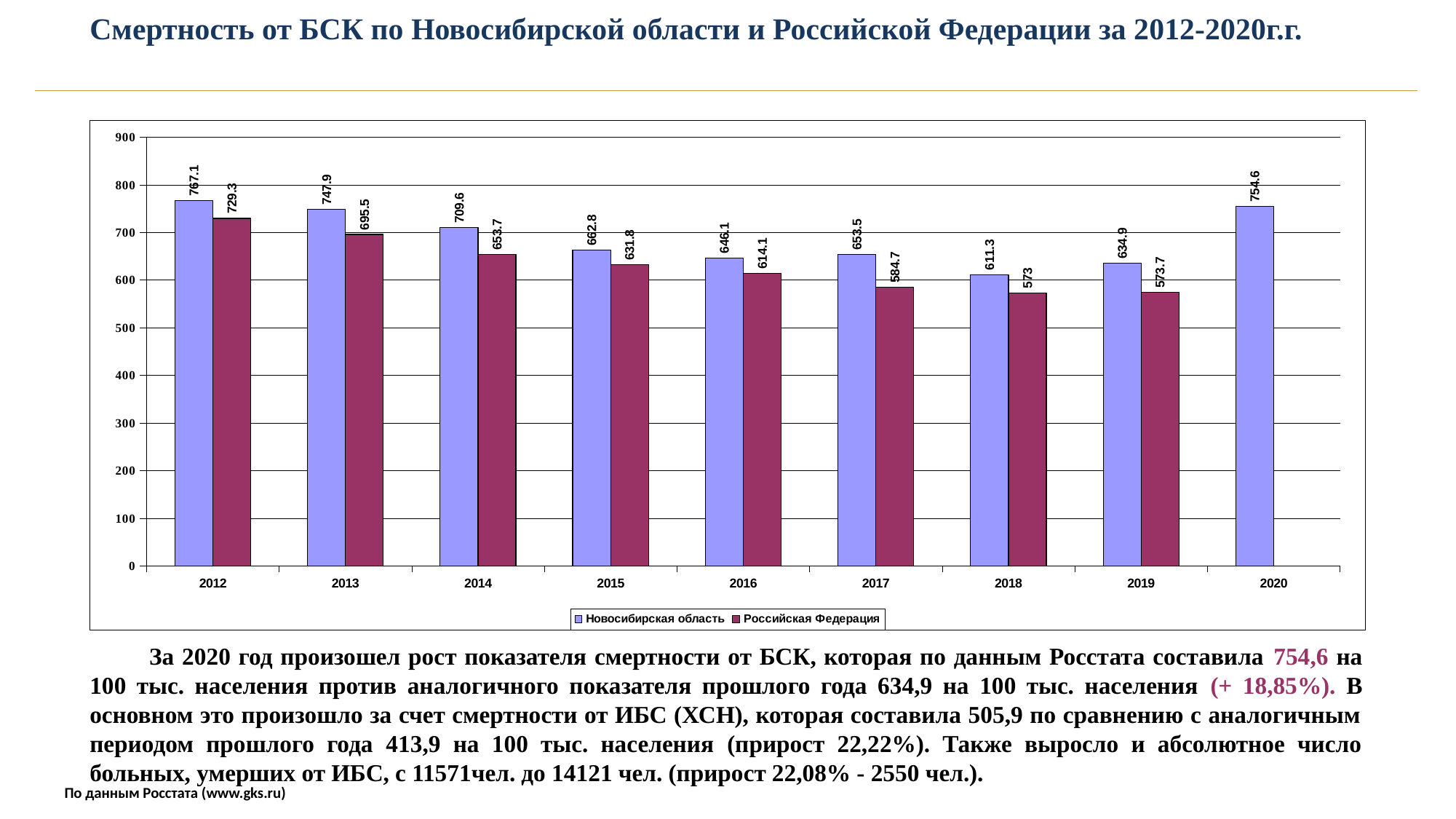
What is the difference between the Новосибирская область and Российская Федерация values in 2012? 37.8 What is the value for Новосибирская область in 2012? 767.1 How many years are shown on the x axis? 9 How many series does the legend list? 2 What is the value for Новосибирская область in 2020? 754.6 Do the values for Российская Федерация rise or fall from 2012 to 2018? fall What is the value for Российская Федерация in 2017? 584.7 In which year is the value for Новосибирская область the lowest? 2018 What kind of chart is shown on the slide? bar chart What is the difference between the Новосибирская область and Российская Федерация values in 2019? 61.2 In which year is the value for Российская Федерация the highest? 2012 Which is larger in 2016: the value for Новосибирская область or for Российская Федерация? Новосибирская область